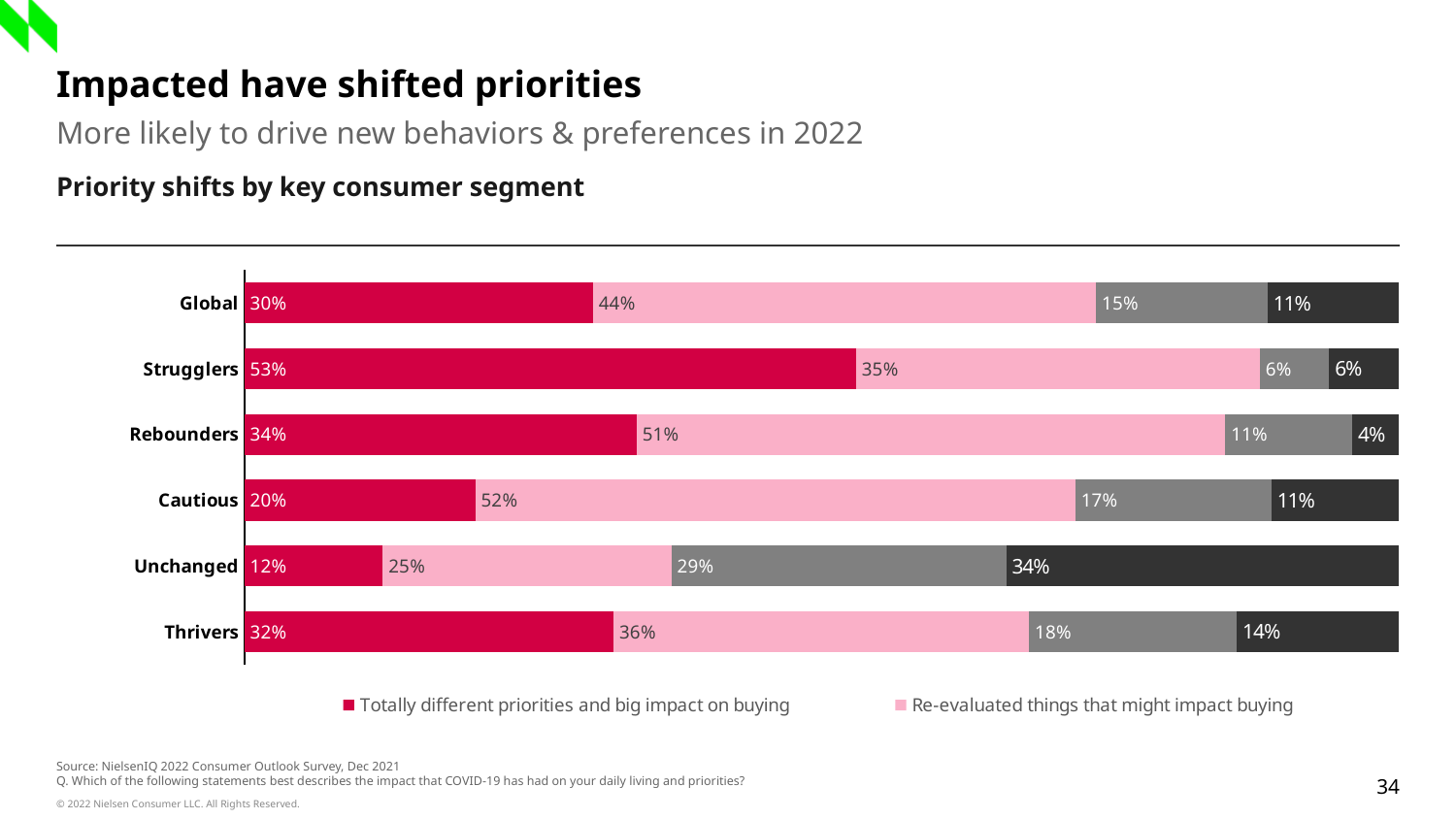
What is the value for Unchanged in the 'Totally different priorities and big impact on buying' series? 12% What is the difference between Strugglers and Global in the 'Totally different priorities and big impact on buying' series? 23 percentage points How many series does the chart legend list? 2 What is the total of all segments in the Global bar? 100% Which segment has the highest value for 'Totally different priorities and big impact on buying'? Strugglers What is the title of the chart? Priority shifts by key consumer segment What is the value for Cautious in the 'Re-evaluated things that might impact buying' series? 52% Which is larger for 'Re-evaluated things that might impact buying': Rebounders or Thrivers? Rebounders Which segment has the lowest value for 'Re-evaluated things that might impact buying'? Unchanged How many consumer segments are plotted on the chart? 6 What type of chart is shown on the slide? Stacked bar chart What is the value for Strugglers in the 'Totally different priorities and big impact on buying' series? 53%